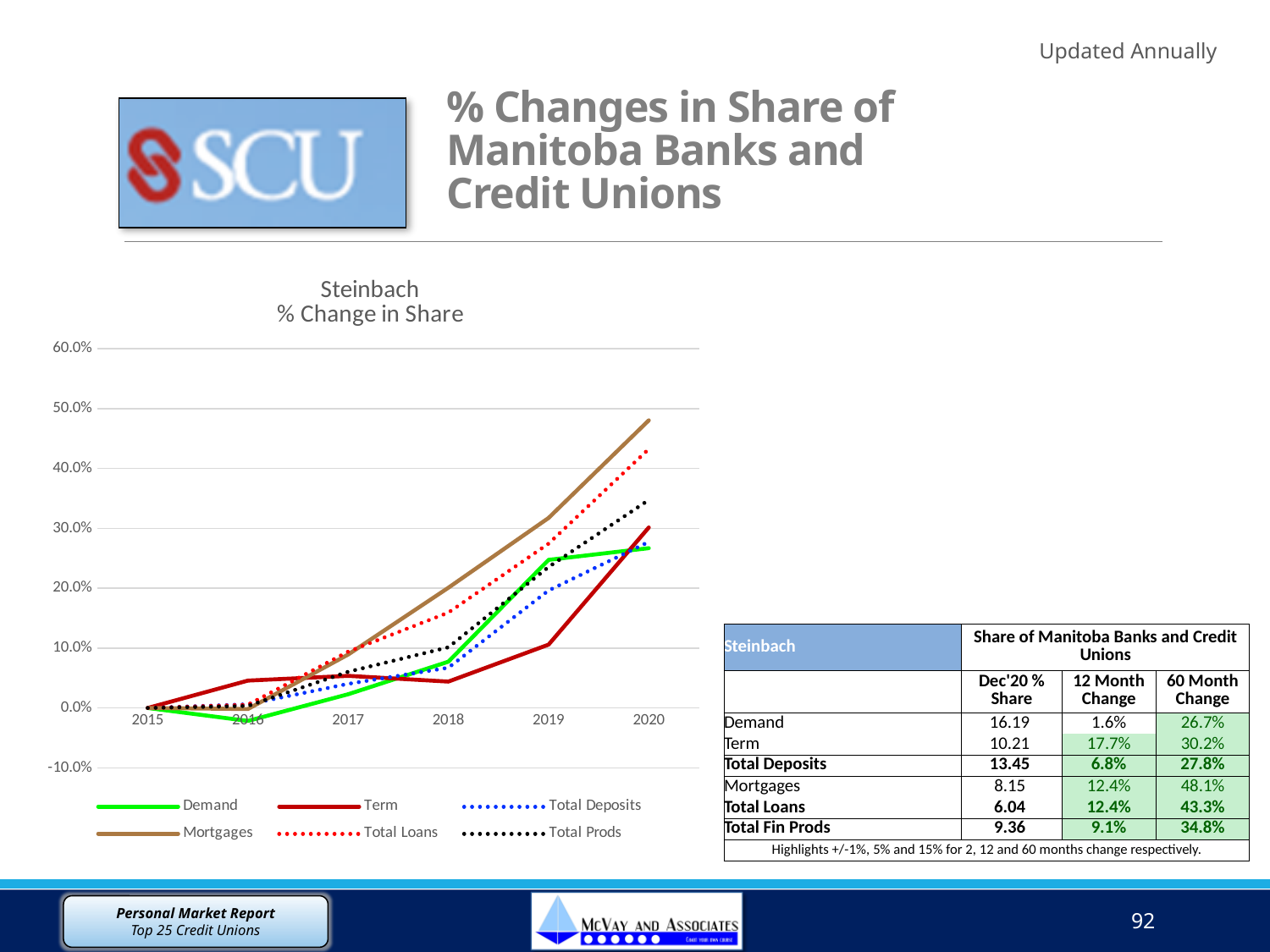
What kind of chart is shown on the slide? line chart How many years are shown along the x axis of the chart? 6 How many series does the chart legend list? 6 Which series has the lowest value in 2016? Demand Is the value for Mortgages in 2020 greater or less than 40.0%? greater Does the Mortgages series rise or fall from 2015 to 2020? rise Is the value for Demand in 2016 greater or less than 0.0%? less Is the value for Mortgages in 2018 greater or less than 10.0%? greater What is the title of the chart? Steinbach % Change in Share Which series has the highest value in 2020? Mortgages Which series is drawn with a solid green line? Demand In 2020, which is larger: Mortgages or Term? Mortgages